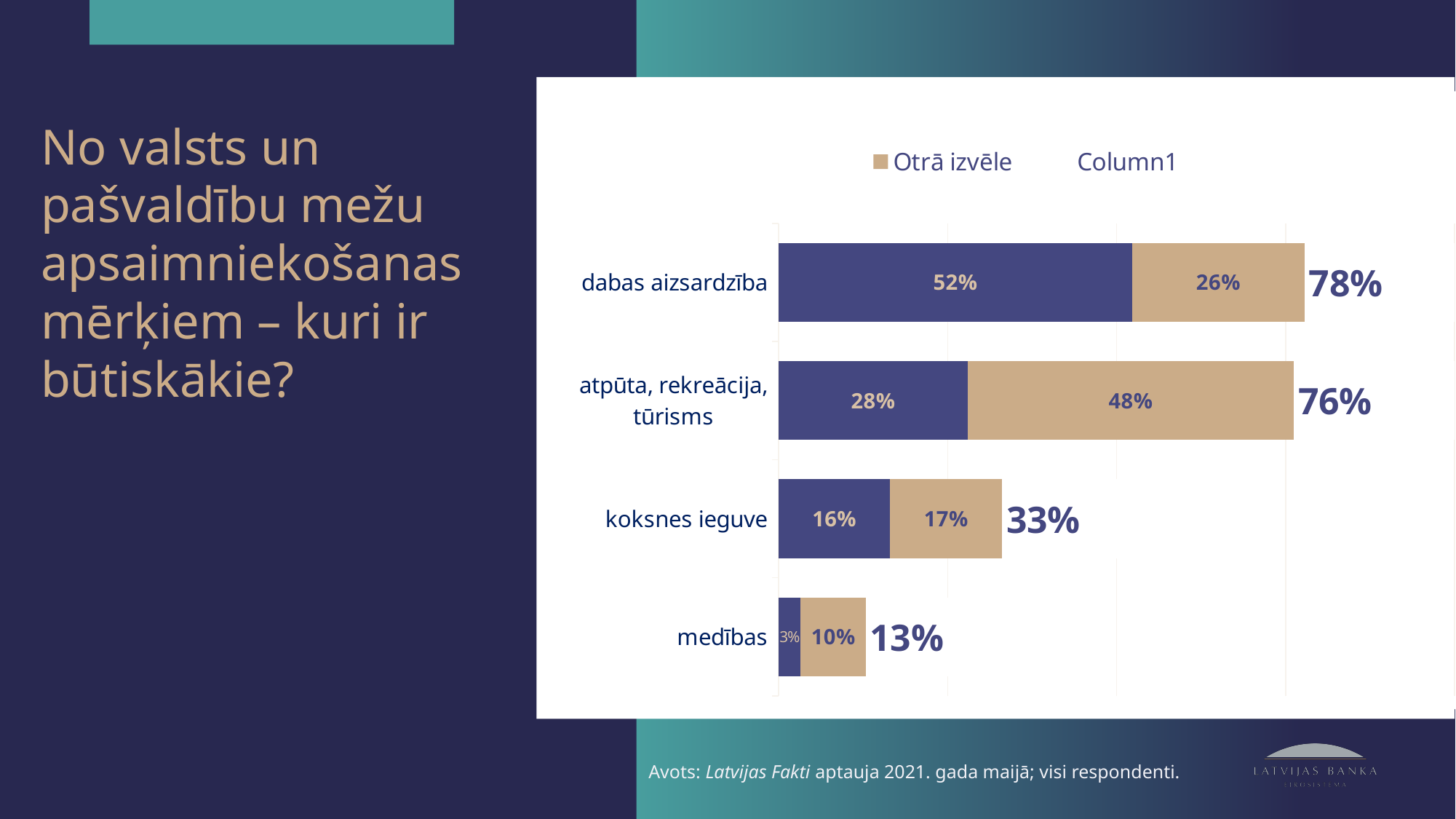
What is the first legend entry shown on the chart? Otrā izvēle What kind of chart is shown on the slide? stacked bar chart What is the total value shown for medības? 13% What is the total value shown for dabas aizsardzība? 78% What is the value of the dark blue segment for dabas aizsardzība? 52% Which is larger: the 'Otrā izvēle' value for dabas aizsardzība or for atpūta, rekreācija, tūrisms? atpūta, rekreācija, tūrisms What is the difference between the total values for koksnes ieguve and medības? 20% Which category has the lowest total value? medības How many categories are shown on the chart? 4 What is the 'Otrā izvēle' value for koksnes ieguve? 17% Which category has the highest total value? dabas aizsardzība What is the 'Otrā izvēle' value for atpūta, rekreācija, tūrisms? 48%